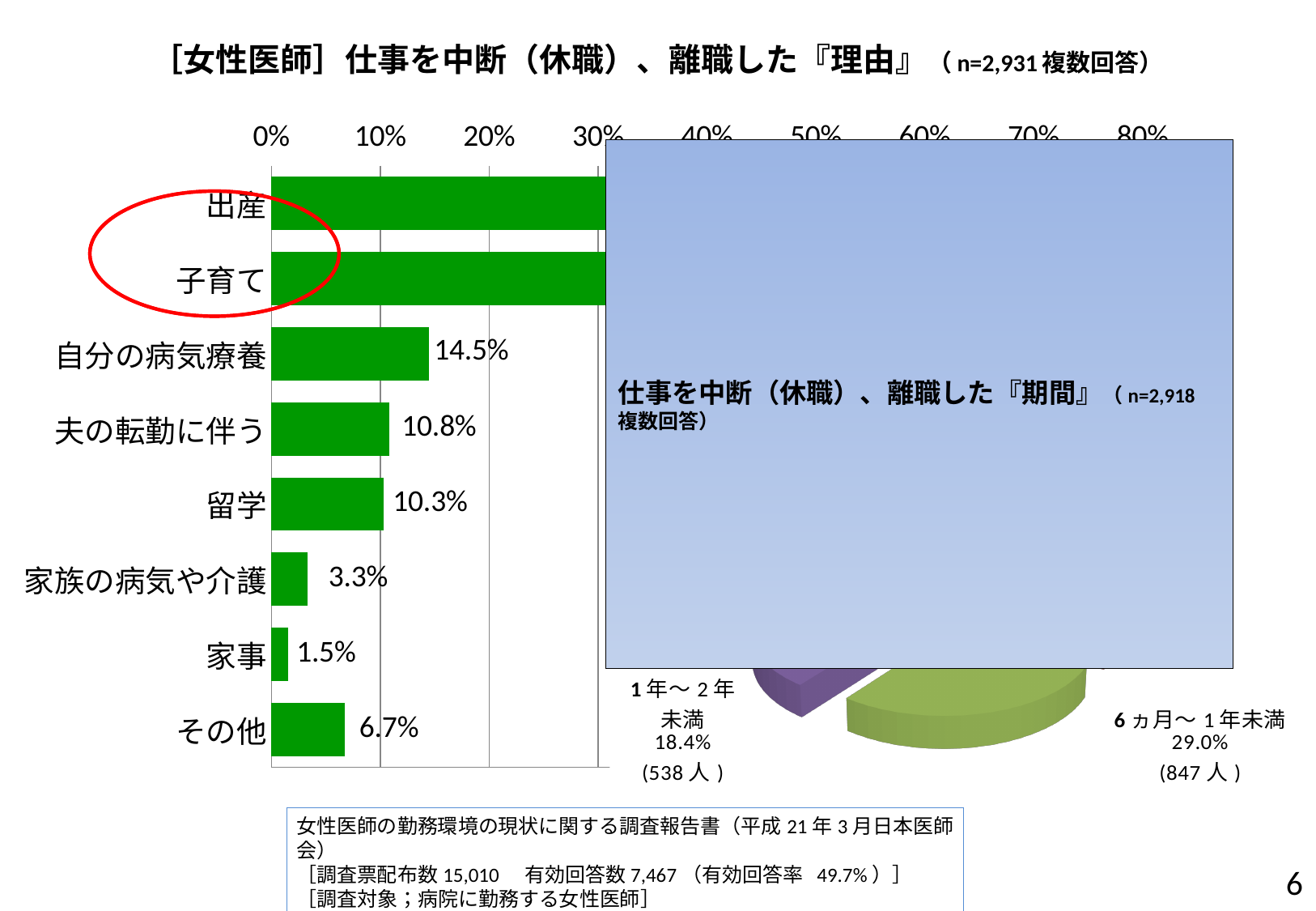
In the bar chart on the left, what is the value for 自分の病気療養? 14.5% In the bar chart on the left, which is larger, the value for その他 or the value for 家族の病気や介護? その他 How many categories does the bar chart on the left show? 8 In the pie chart on the right, what share is shown for 6ヵ月～1年未満? 29.0% In the bar chart on the left, what is the value for 留学? 10.3% What kind of chart is the chart on the left of the slide? bar chart In the bar chart on the left, is the value for 出産 greater or less than 30%? greater In the pie chart on the right, how many people are shown for 1年～2年未満? 538人 In the bar chart on the left, what is the value for 家族の病気や介護? 3.3% In the bar chart on the left, what is the value for 夫の転勤に伴う? 10.8% In the bar chart on the left, which category has the lowest value? 家事 In the bar chart on the left, what is the difference between the values for 自分の病気療養 and 夫の転勤に伴う? 3.7%